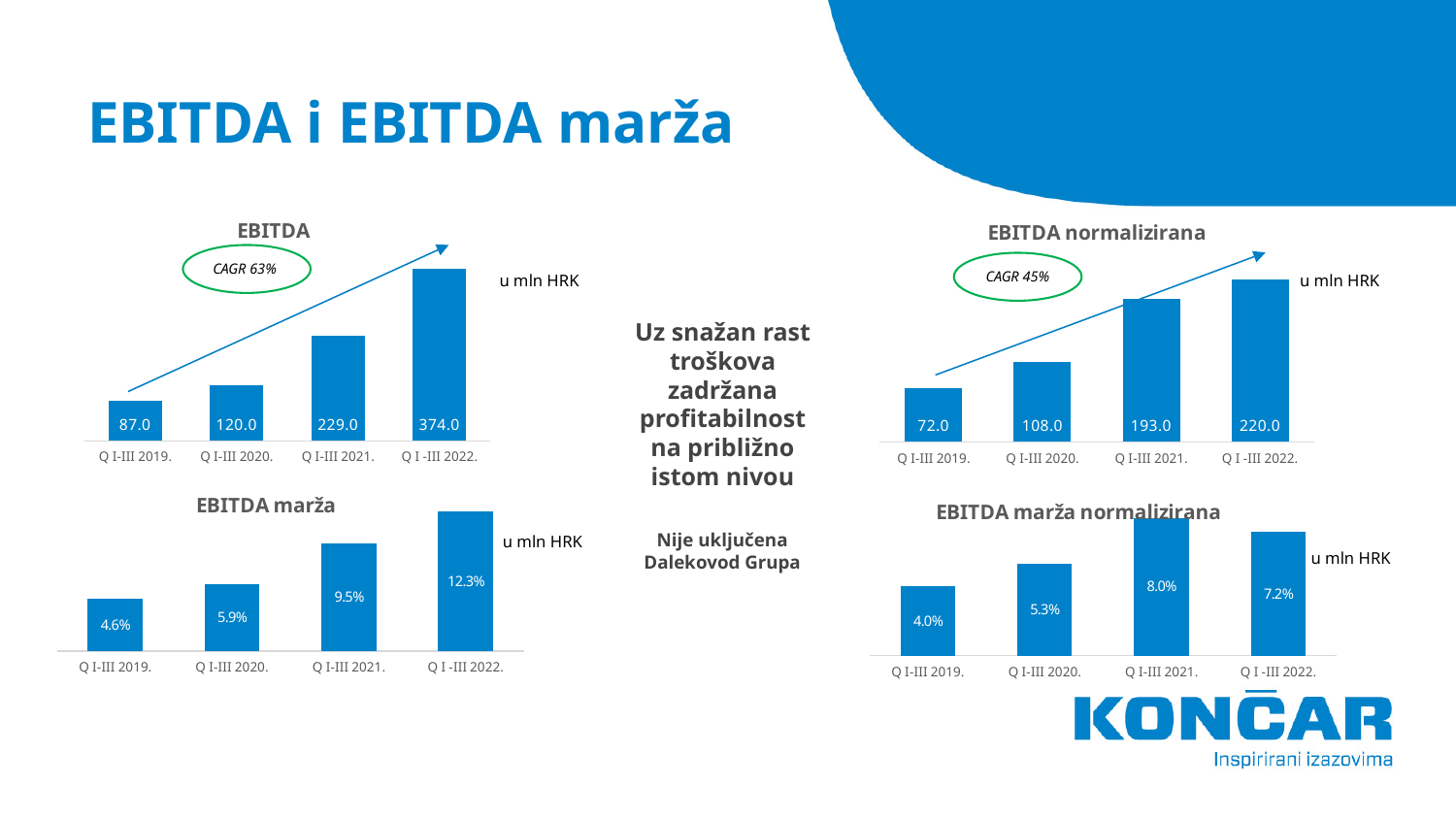
How many periods are shown in the EBITDA chart? 4 In the EBITDA chart, what is the value for Q I-III 2021.? 229.0 In the EBITDA normalizirana chart, which period has the lowest value? Q I-III 2019. In the EBITDA chart, what is the difference between Q I -III 2022. and Q I-III 2019.? 287.0 In the EBITDA normalizirana chart, what is the difference between Q I -III 2022. and Q I-III 2021.? 27.0 In the EBITDA chart, which period has the highest value? Q I -III 2022. In the EBITDA marža chart, what is the value for Q I -III 2022.? 12.3% In the EBITDA normalizirana chart, what is the value for Q I-III 2020.? 108.0 What type of chart is the EBITDA marža chart? bar chart In the EBITDA marža normalizirana chart, what is the value for Q I-III 2021.? 8.0% In the EBITDA marža normalizirana chart, which is larger, Q I-III 2021. or Q I -III 2022.? Q I-III 2021. In the EBITDA marža chart, do the values rise or fall from Q I-III 2019. to Q I -III 2022.? rise